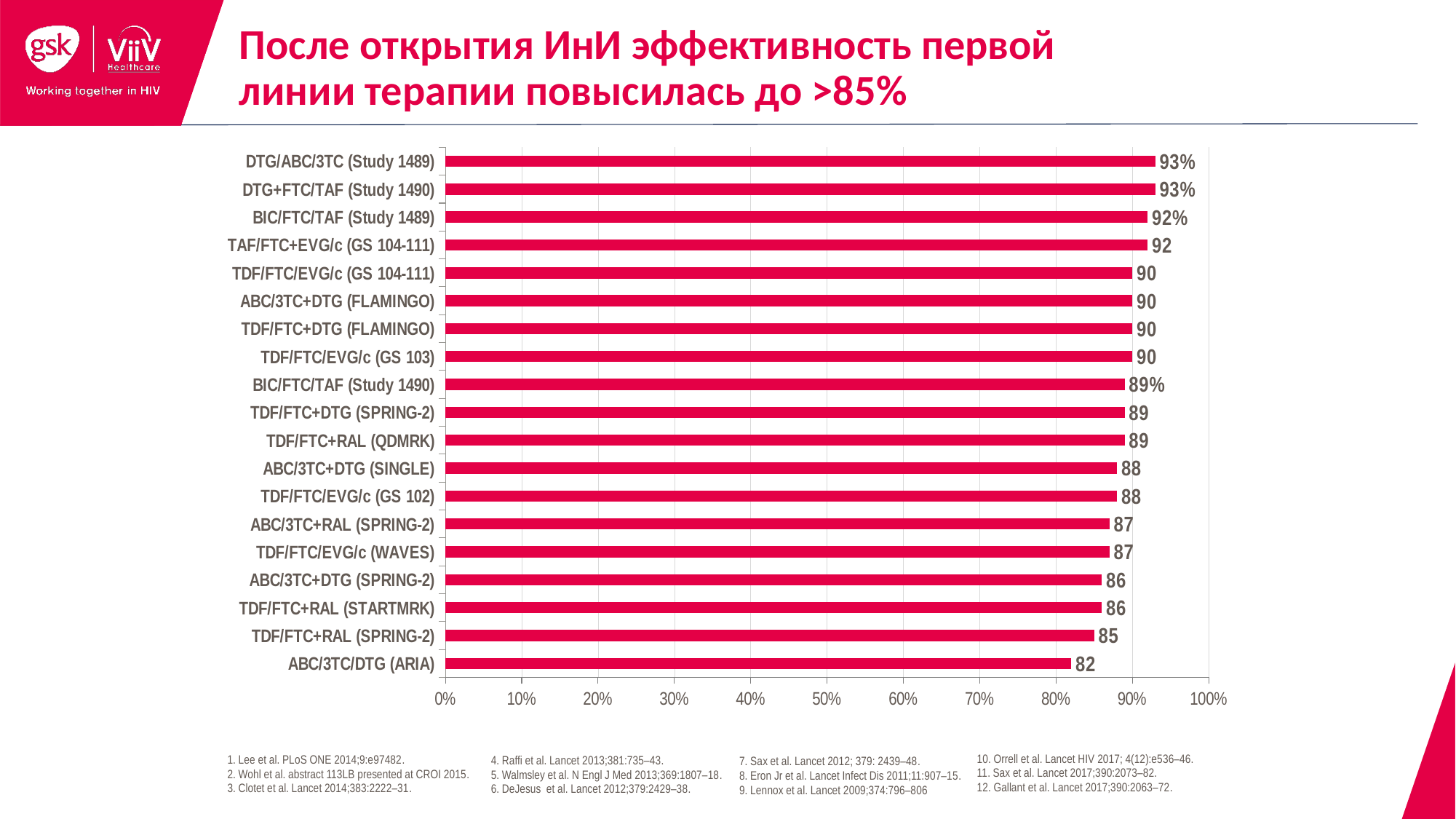
What is the value shown for TDF/FTC+RAL (SPRING-2)? 85 What kind of chart is shown on the slide? bar chart Is the value for ABC/3TC/DTG (ARIA) greater or less than 90%? less What is the value shown for DTG/ABC/3TC (Study 1489)? 93% Which category has the lowest value? ABC/3TC/DTG (ARIA) What is the difference between the values for TDF/FTC/EVG/c (GS 103) and TDF/FTC+RAL (QDMRK)? 1 What is the value shown for BIC/FTC/TAF (Study 1490)? 89% How many categories (bars) are shown in the chart? 19 Which is larger, the value for ABC/3TC+DTG (SINGLE) or the value for TDF/FTC+RAL (STARTMRK)? ABC/3TC+DTG (SINGLE) What is the value shown for TDF/FTC/EVG/c (WAVES)? 87 What is the value shown for ABC/3TC/DTG (ARIA)? 82 What is the difference between the values for DTG+FTC/TAF (Study 1490) and ABC/3TC/DTG (ARIA)? 11